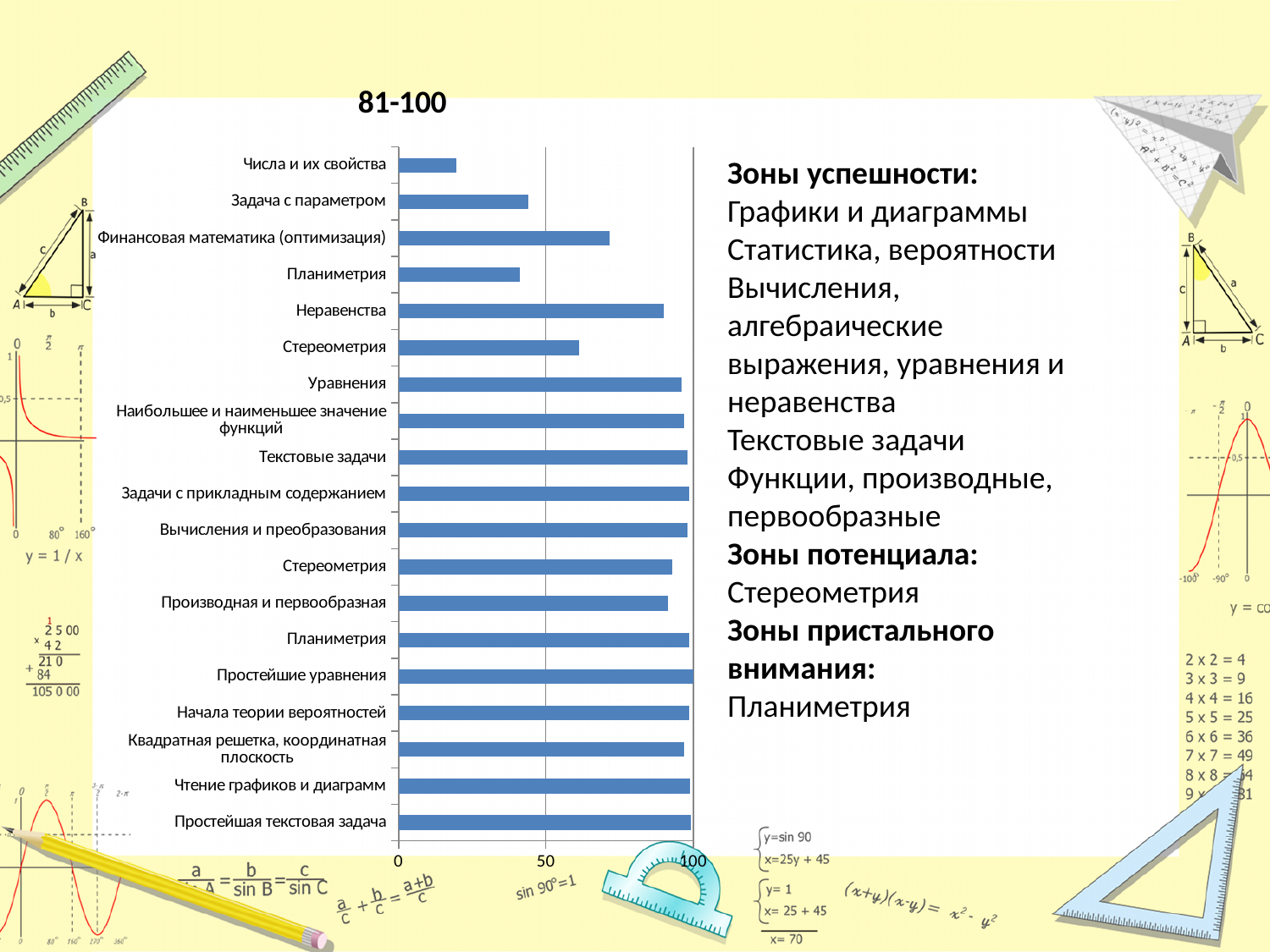
What is the title of the chart? 81-100 Is the value for Финансовая математика (оптимизация) greater or less than 50? greater What kind of chart is shown on the slide? bar chart Is the value for Задача с параметром greater or less than 50? less Which has a larger value, Финансовая математика (оптимизация) or Задача с параметром? Финансовая математика (оптимизация) Is the value for Неравенства greater or less than 50? greater Which category has the lowest value in the chart? Числа и их свойства Which has a larger value, Неравенства or Числа и их свойства? Неравенства How many categories are plotted in the chart? 19 What colour are the bars in the chart? blue